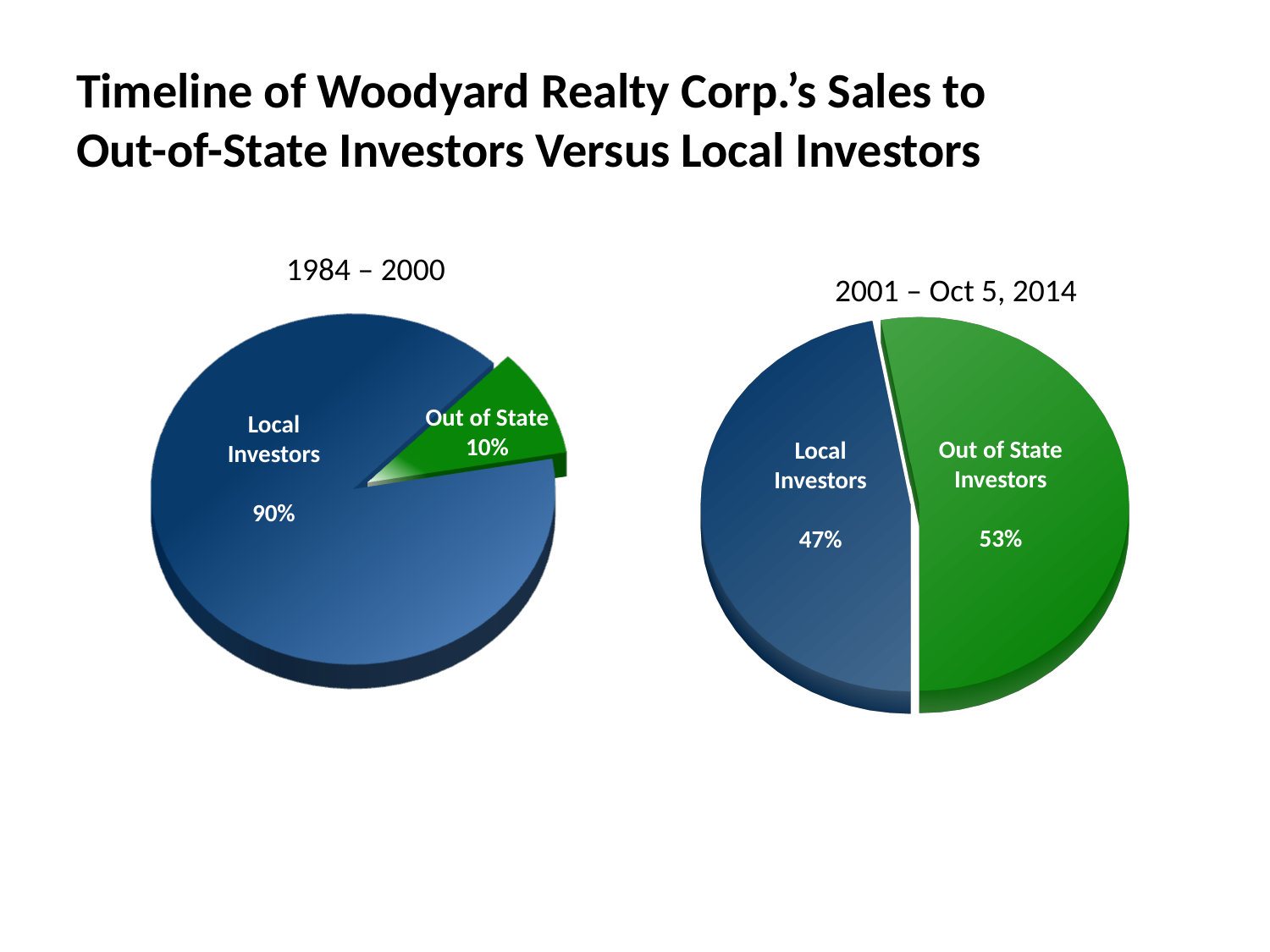
In the 1984 – 2000 pie chart, what share of sales went to Local Investors? 90% In the 2001 – Oct 5, 2014 pie chart, which is larger: Local Investors or Out of State Investors? Out of State Investors In the 1984 – 2000 pie chart, what is the difference between the Local Investors share and the Out of State share? 80% In the 2001 – Oct 5, 2014 pie chart, what is the difference between the Out of State Investors share and the Local Investors share? 6% In the 2001 – Oct 5, 2014 pie chart, what share of sales went to Local Investors? 47% What kind of chart is the 2001 – Oct 5, 2014 chart? Pie chart In the 2001 – Oct 5, 2014 pie chart, which slice is the smallest? Local Investors How many slices does the 1984 – 2000 pie chart have? 2 In the 1984 – 2000 pie chart, what share of sales went to Out of State investors? 10% In the 2001 – Oct 5, 2014 pie chart, what share of sales went to Out of State Investors? 53% In the 1984 – 2000 pie chart, which slice is the largest? Local Investors What colour is the Out of State slice in the 1984 – 2000 pie chart? Green